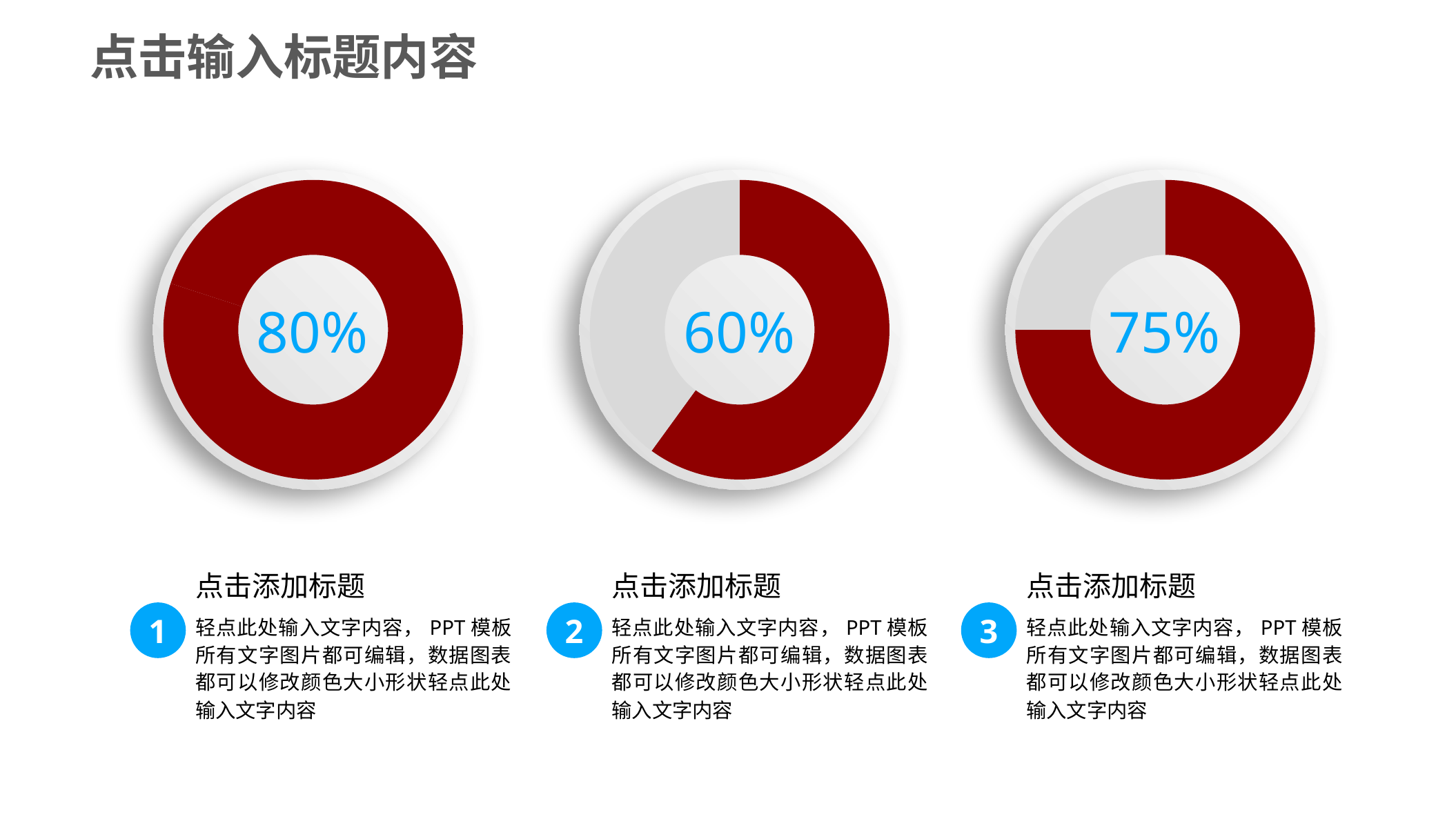
What percentage is shown in the centre of the middle donut chart? 60% What percentage is shown in the centre of the right donut chart? 75% Is the percentage in the right donut chart larger or smaller than the percentage in the middle donut chart? larger In the middle donut chart, what share of the ring is filled in red? 60% What is the difference between the percentage in the left donut chart and the percentage in the middle donut chart? 20% How many donut charts are on the slide? 3 What colour is the filled portion of the rings in the three donut charts? dark red Which of the three donut charts shows the highest percentage: left, middle or right? left What kind of chart is used three times on this slide? donut chart Which of the three donut charts shows the lowest percentage: left, middle or right? middle What is the difference between the percentage in the right donut chart and the percentage in the middle donut chart? 15% What percentage is shown in the centre of the left donut chart? 80%